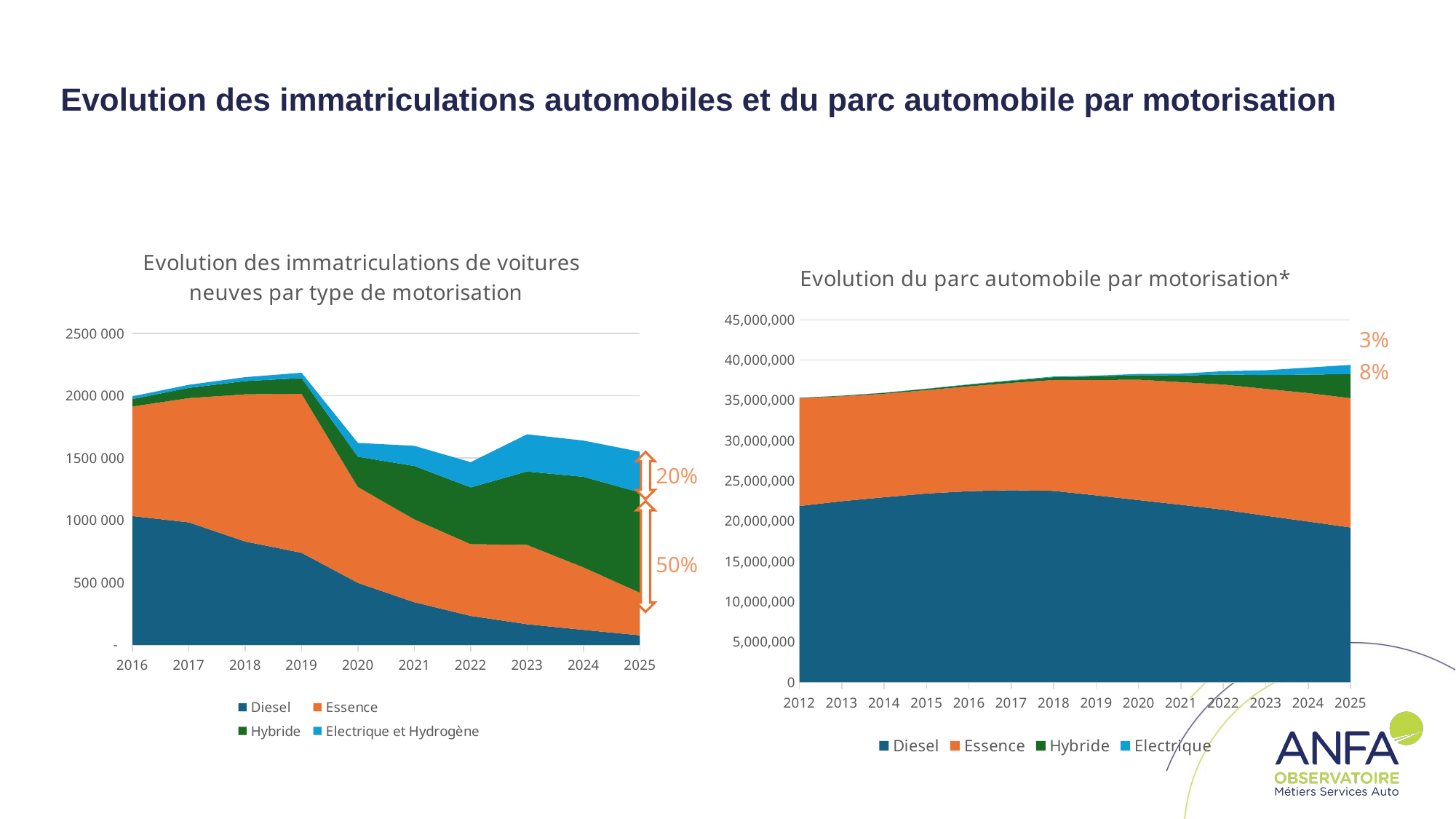
In the right chart, 'Evolution du parc automobile par motorisation*', is the Diesel value for 2012 greater or less than 20,000,000? greater In the left chart, 'Evolution des immatriculations de voitures neuves par type de motorisation', does the Diesel series rise or fall from 2016 to 2025? Fall In the right chart, 'Evolution du parc automobile par motorisation*', what two percentages are annotated at the right edge of the chart? 3% and 8% In the left chart, 'Evolution des immatriculations de voitures neuves par type de motorisation', which is larger in 2025: the Hybride band or the Diesel band? Hybride In the right chart, 'Evolution du parc automobile par motorisation*', is the total stacked value for 2025 greater or less than 40,000,000? less How many years are shown on the x axis of the right chart, 'Evolution du parc automobile par motorisation*'? 14 In the right chart, 'Evolution du parc automobile par motorisation*', which is larger in 2025: the Diesel band or the Essence band? Diesel What kind of chart is the left chart, 'Evolution des immatriculations de voitures neuves par type de motorisation'? Stacked area chart How many years are shown on the x axis of the left chart, 'Evolution des immatriculations de voitures neuves par type de motorisation'? 10 In the left chart, 'Evolution des immatriculations de voitures neuves par type de motorisation', what percentage is annotated next to the Electrique et Hydrogène band in 2025? 20% How many series does the legend of the right chart, 'Evolution du parc automobile par motorisation*', list? 4 In the left chart, 'Evolution des immatriculations de voitures neuves par type de motorisation', is the Diesel value for 2019 greater or less than 1000 000? less